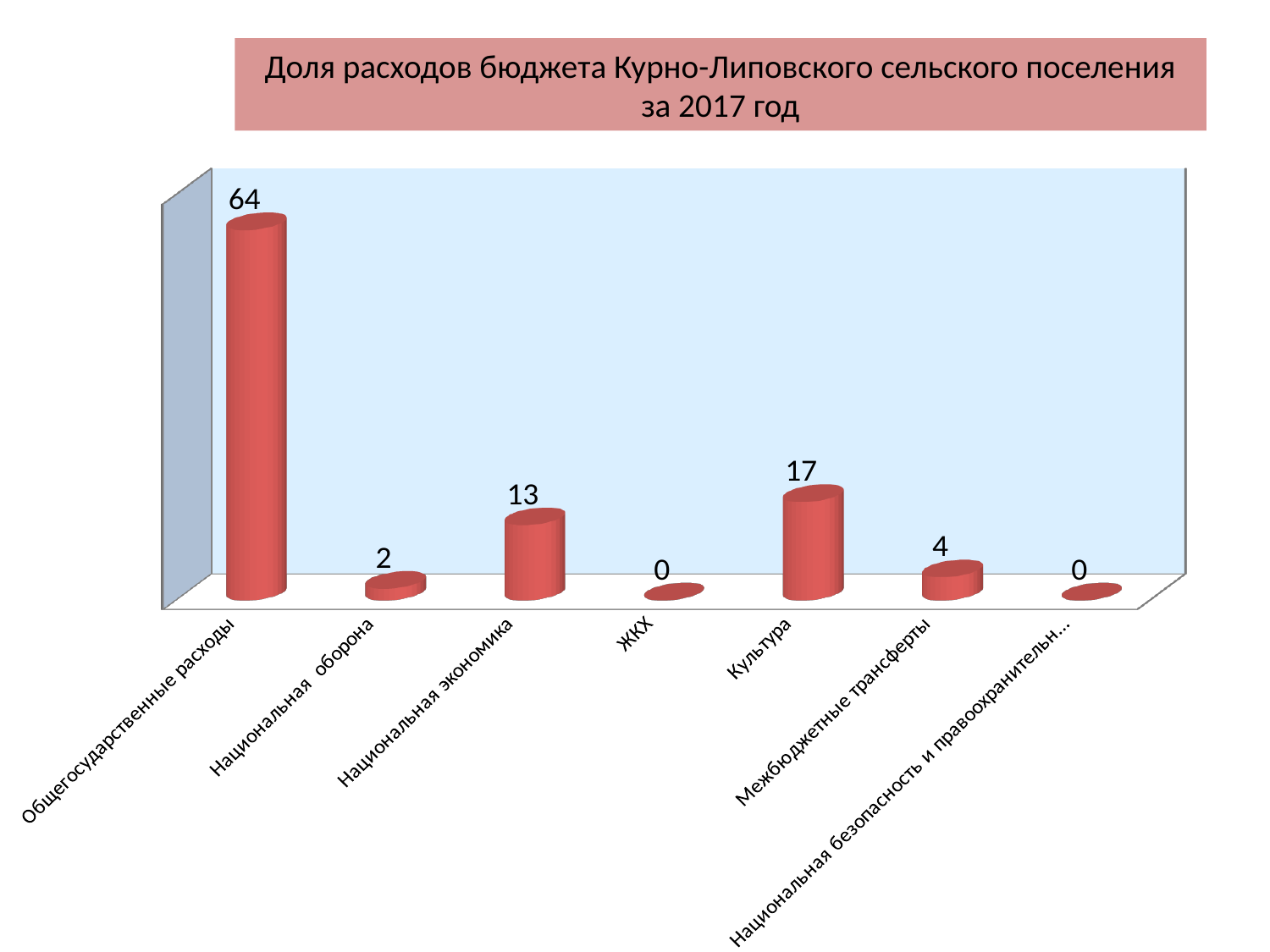
What is the value for ЖКХ? 0 What is the value for Культура? 17 What is the value for Межбюджетные трансферты? 4 What is the value for Национальная экономика? 13 What kind of chart is shown on the slide? bar chart What is the title of the chart? Доля расходов бюджета Курно-Липовского сельского поселения за 2017 год Which is larger, the value for Культура or the value for Национальная экономика? Культура What is the difference between the values for Общегосударственные расходы and Культура? 47 What is the value for Национальная оборона? 2 Which category has the highest value? Общегосударственные расходы What is the value for Общегосударственные расходы? 64 How many categories are shown on the x axis? 7